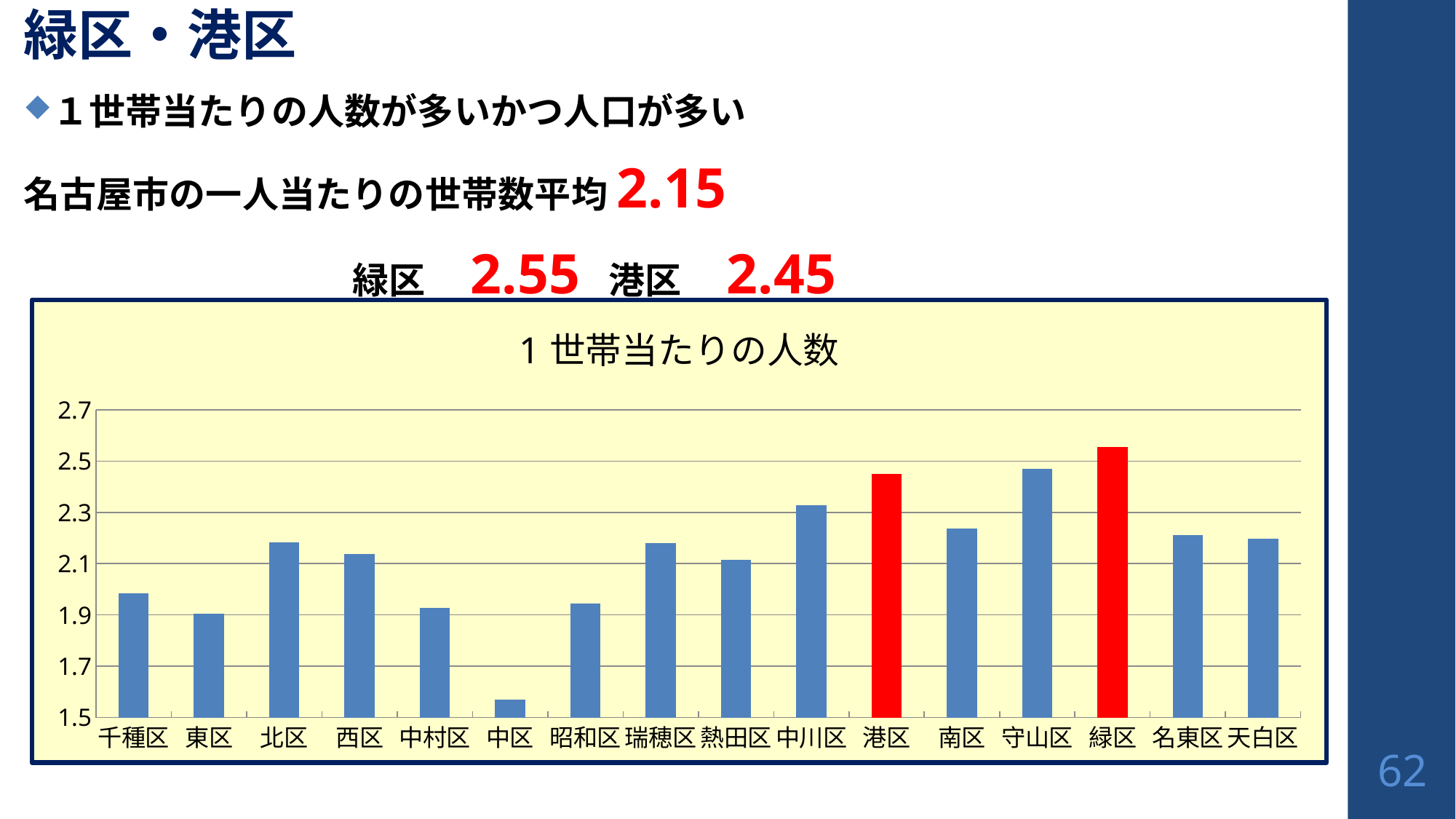
How many wards (categories) are plotted on the x axis of the chart? 16 What is the title of the chart? １世帯当たりの人数 Which has the larger value, 港区 or 中川区? 港区 What is the difference between the values for 緑区 and 港区? 0.1 Which ward has the highest value in the chart? 緑区 What is the value for 緑区 (persons per household)? 2.55 Is the value for 守山区 greater or less than 2.3? greater What is the value for 港区 (persons per household)? 2.45 Which ward has the lowest value in the chart? 中区 Is the value for 中区 greater or less than 1.7? less Which two wards are shown with red bars in the chart? 港区 and 緑区 What kind of chart is shown on the slide? bar chart